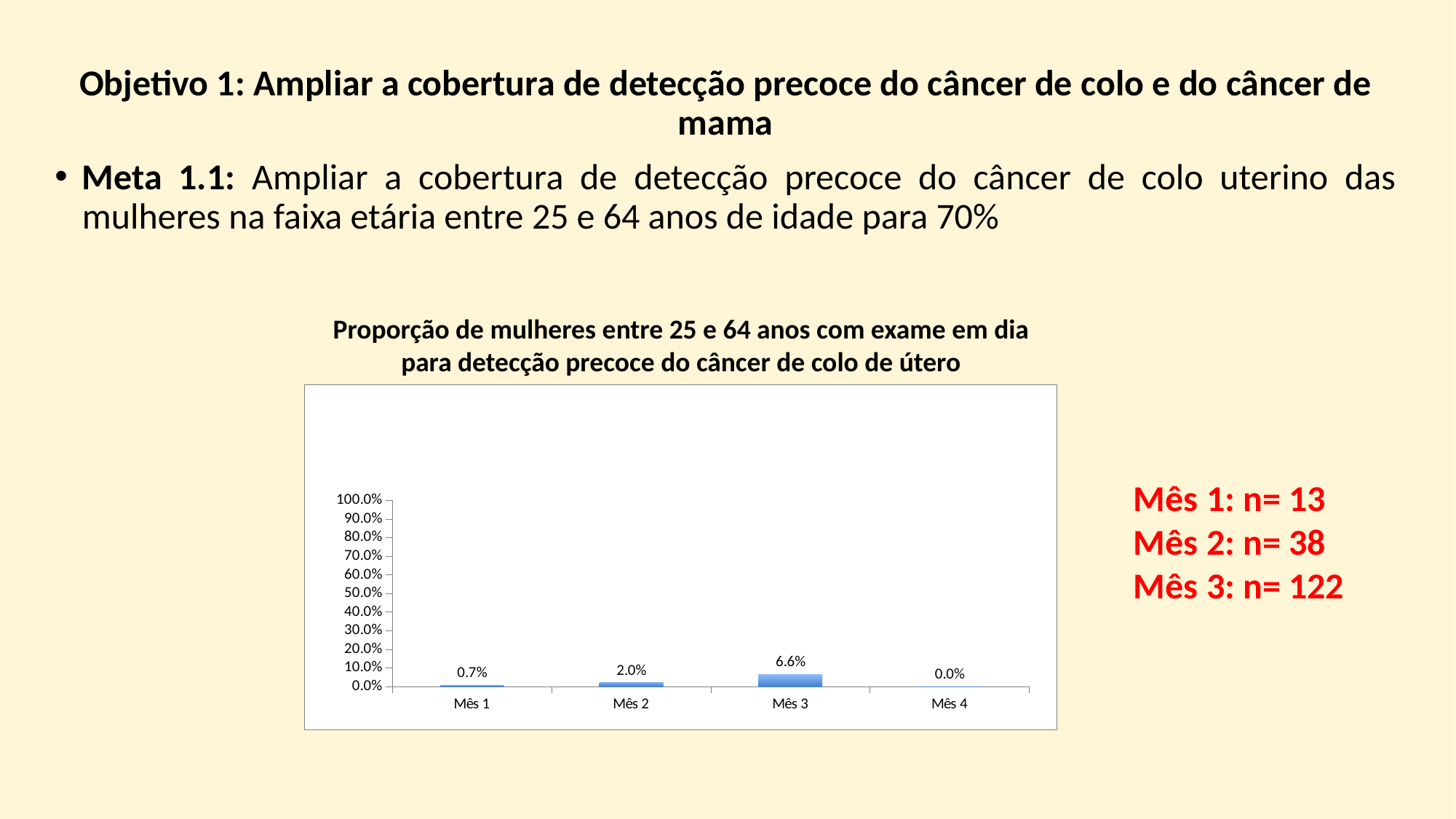
Which month has the highest value? Mês 3 What is the title of the chart? Proporção de mulheres entre 25 e 64 anos com exame em dia para detecção precoce do câncer de colo de útero Is the value for Mês 3 greater or less than 10.0%? less How many months are shown on the x axis? 4 What is the value for Mês 3? 6.6% What kind of chart is shown on the slide? bar chart What is the difference between the values for Mês 3 and Mês 2? 4.6% What is the value for Mês 4? 0.0% Which month has the lowest value? Mês 4 Which is larger, the value for Mês 1 or the value for Mês 2? Mês 2 What is the value for Mês 2? 2.0% What is the value for Mês 1? 0.7%